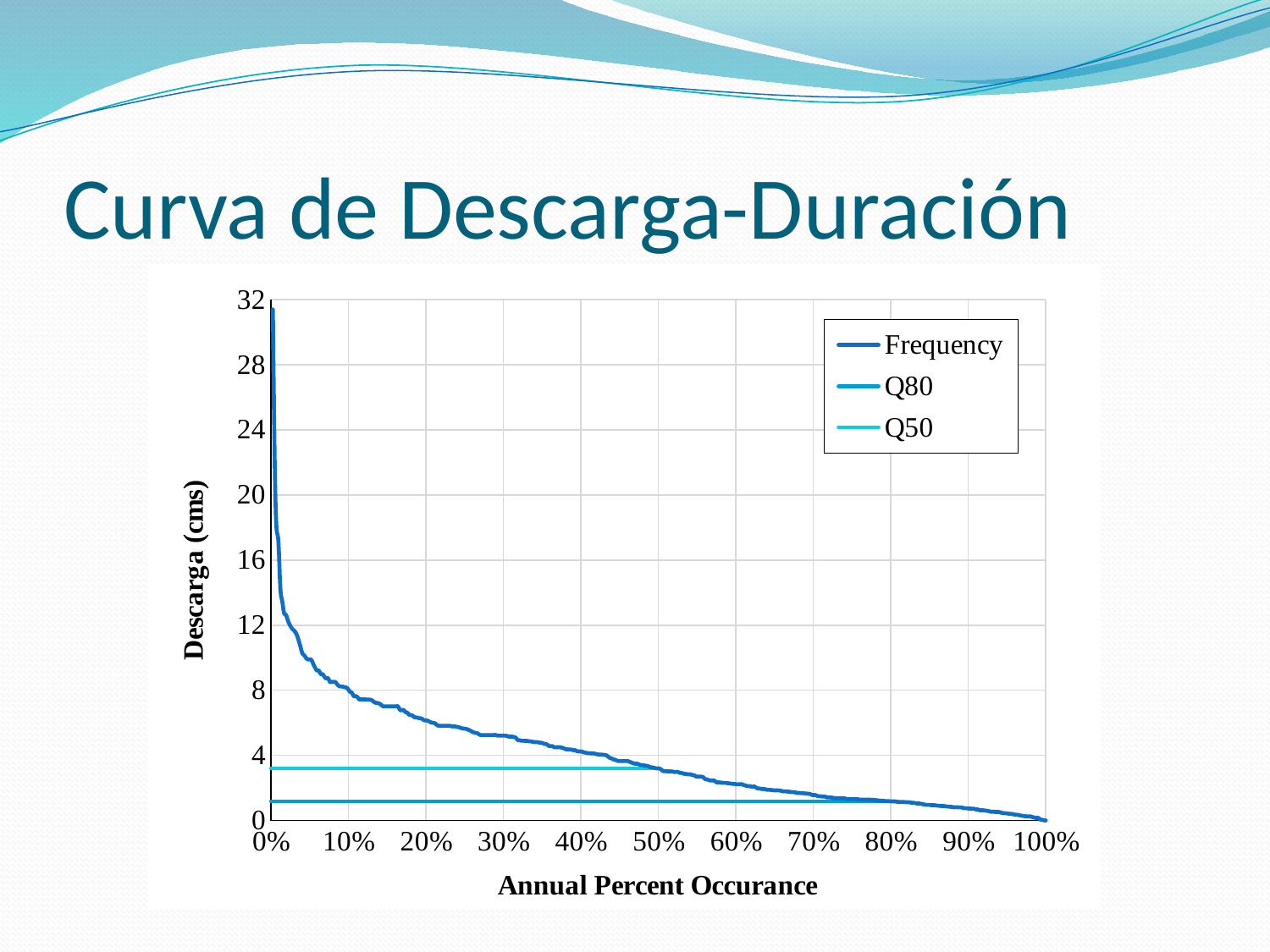
Is the Frequency value at 0% Annual Percent Occurance greater or less than 28? greater Is the Q80 line greater or less than 4 on the Descarga axis? less Is the Frequency value at 10% Annual Percent Occurance greater or less than 12? less Does the Frequency series rise or fall as Annual Percent Occurance increases from 0% to 100%? fall Which horizontal line sits higher on the chart, Q50 or Q80? Q50 What kind of chart is shown on the slide? line chart What are the three series named in the legend? Frequency, Q80, Q50 What is the title of the y axis? Descarga (cms) How many series does the legend list? 3